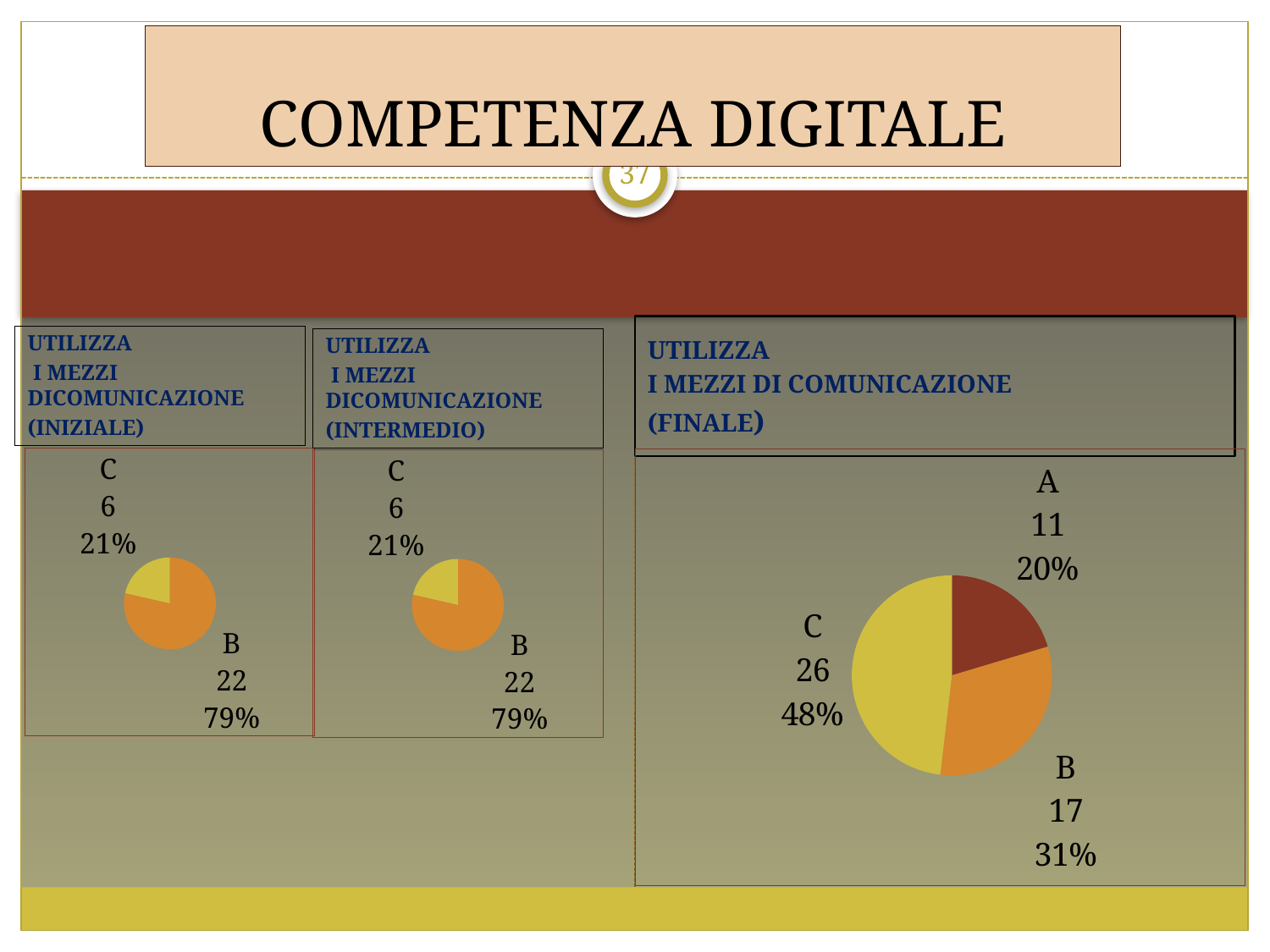
In the UTILIZZA I MEZZI DICOMUNICAZIONE (INTERMEDIO) chart, which category is larger, B or C? B In the UTILIZZA I MEZZI DICOMUNICAZIONE (INTERMEDIO) chart, what is the difference between the values for B and C? 16 What type of chart is used in the UTILIZZA I MEZZI DI COMUNICAZIONE (FINALE) panel? Pie chart In the UTILIZZA I MEZZI DI COMUNICAZIONE (FINALE) chart, what is the value for category C? 26 In the UTILIZZA I MEZZI DI COMUNICAZIONE (FINALE) chart, what is the difference between the values for C and B? 9 In the UTILIZZA I MEZZI DI COMUNICAZIONE (FINALE) chart, how many categories are shown? 3 In the UTILIZZA I MEZZI DI COMUNICAZIONE (FINALE) chart, what percentage share does category A have? 20% In the UTILIZZA I MEZZI DI COMUNICAZIONE (FINALE) chart, which category has the largest slice? C In the UTILIZZA I MEZZI DI COMUNICAZIONE (FINALE) chart, which category has the smallest slice? A In the UTILIZZA I MEZZI DICOMUNICAZIONE (INIZIALE) chart, what is the value for category B? 22 In the UTILIZZA I MEZZI DI COMUNICAZIONE (FINALE) chart, what is the value for category B? 17 In the UTILIZZA I MEZZI DICOMUNICAZIONE (INIZIALE) chart, what percentage share does category C have? 21%